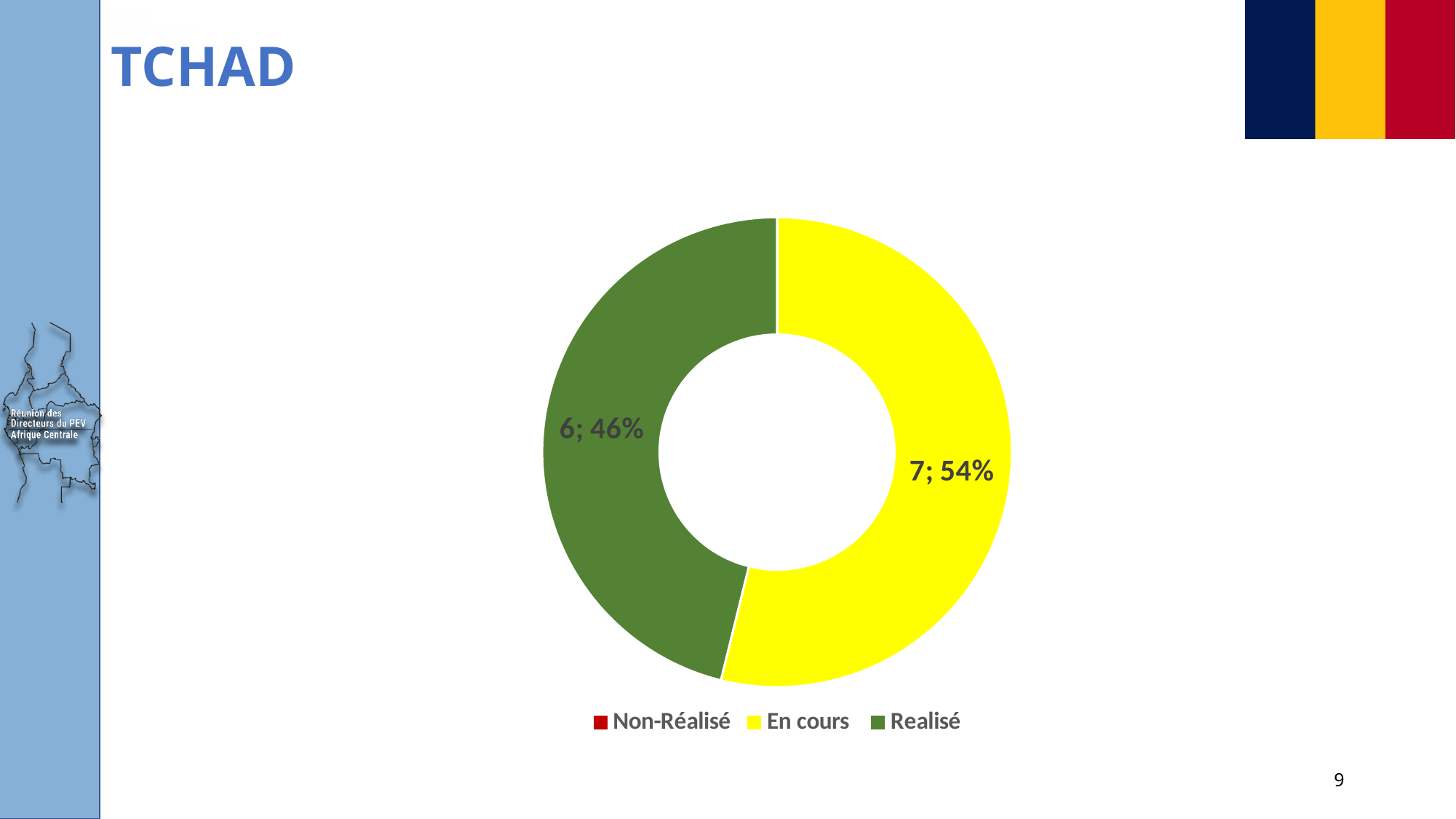
What colour represents the Realisé category in the legend? Green What is the count shown for the Realisé slice? 6 Which category has the largest slice? En cours What is the total of the counts shown on the chart? 13 What kind of chart is shown on the slide? Pie chart (doughnut) What share of the pie does the En cours slice represent? 54% Which of the two visible slices is smaller, En cours or Realisé? Realisé What is the count shown for the En cours slice? 7 How many entries does the legend list? 3 Which is larger, the Realisé share or the En cours share? En cours What is the difference between the En cours count and the Realisé count? 1 What share of the pie does the Realisé slice represent? 46%